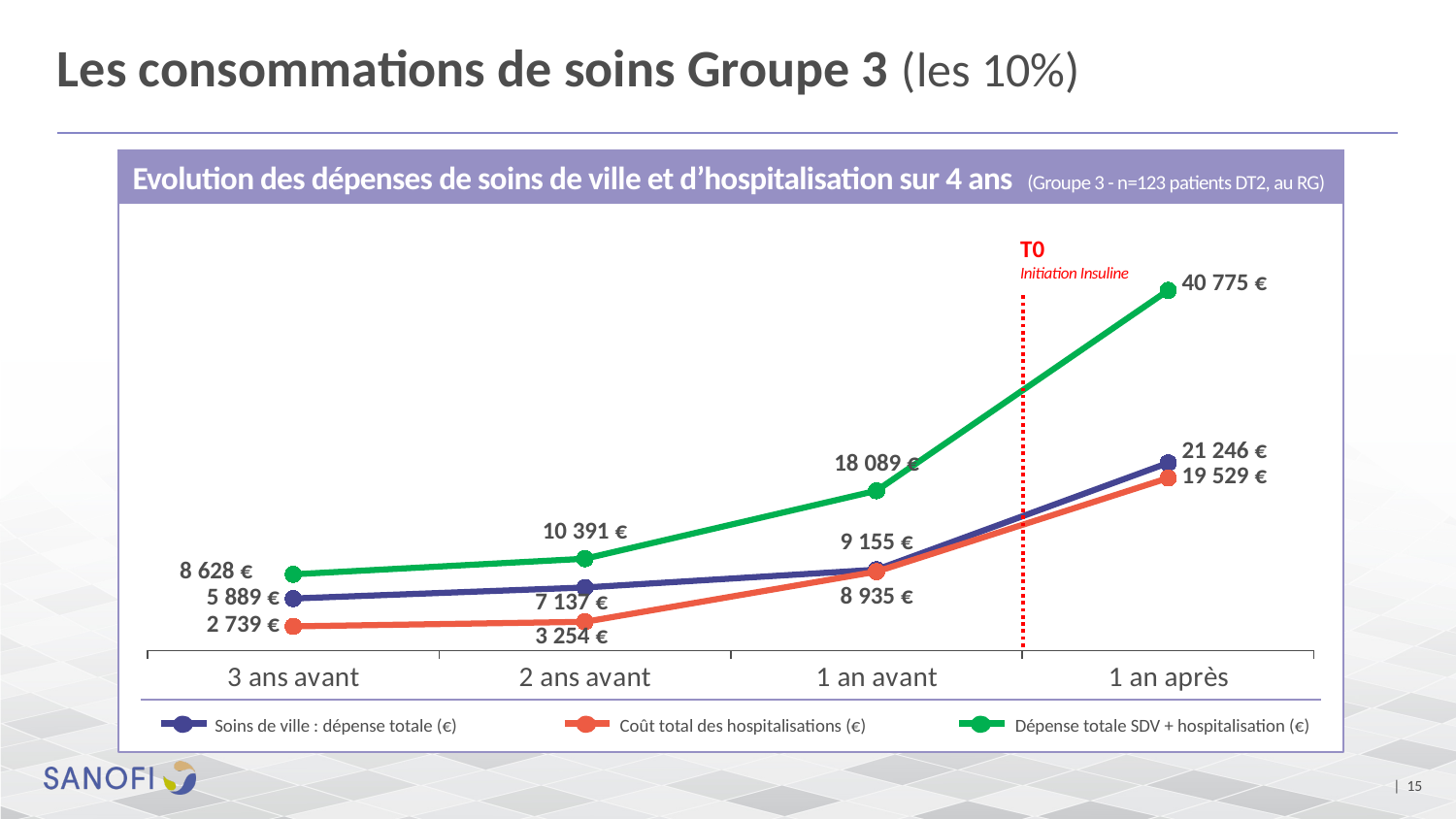
What is the value of Dépense totale SDV + hospitalisation (€) at 1 an avant? 18 089 € By how much does Dépense totale SDV + hospitalisation (€) increase from 1 an avant to 1 an après? 22 686 € How many time points are shown on the x axis? 4 What is the value of Dépense totale SDV + hospitalisation (€) at 1 an après? 40 775 € At 2 ans avant, which is larger: Soins de ville : dépense totale (€) or Coût total des hospitalisations (€)? Soins de ville : dépense totale (€) How many series does the legend list? 3 What is the Coût total des hospitalisations (€) at 2 ans avant? 3 254 € What is the value of Soins de ville : dépense totale (€) at 3 ans avant? 5 889 € At which time point is Soins de ville : dépense totale (€) lowest? 3 ans avant What kind of chart is shown on the slide? Line chart At which time point is the Coût total des hospitalisations (€) highest? 1 an après At 1 an après, what is the difference between Soins de ville : dépense totale (€) and Coût total des hospitalisations (€)? 1 717 €